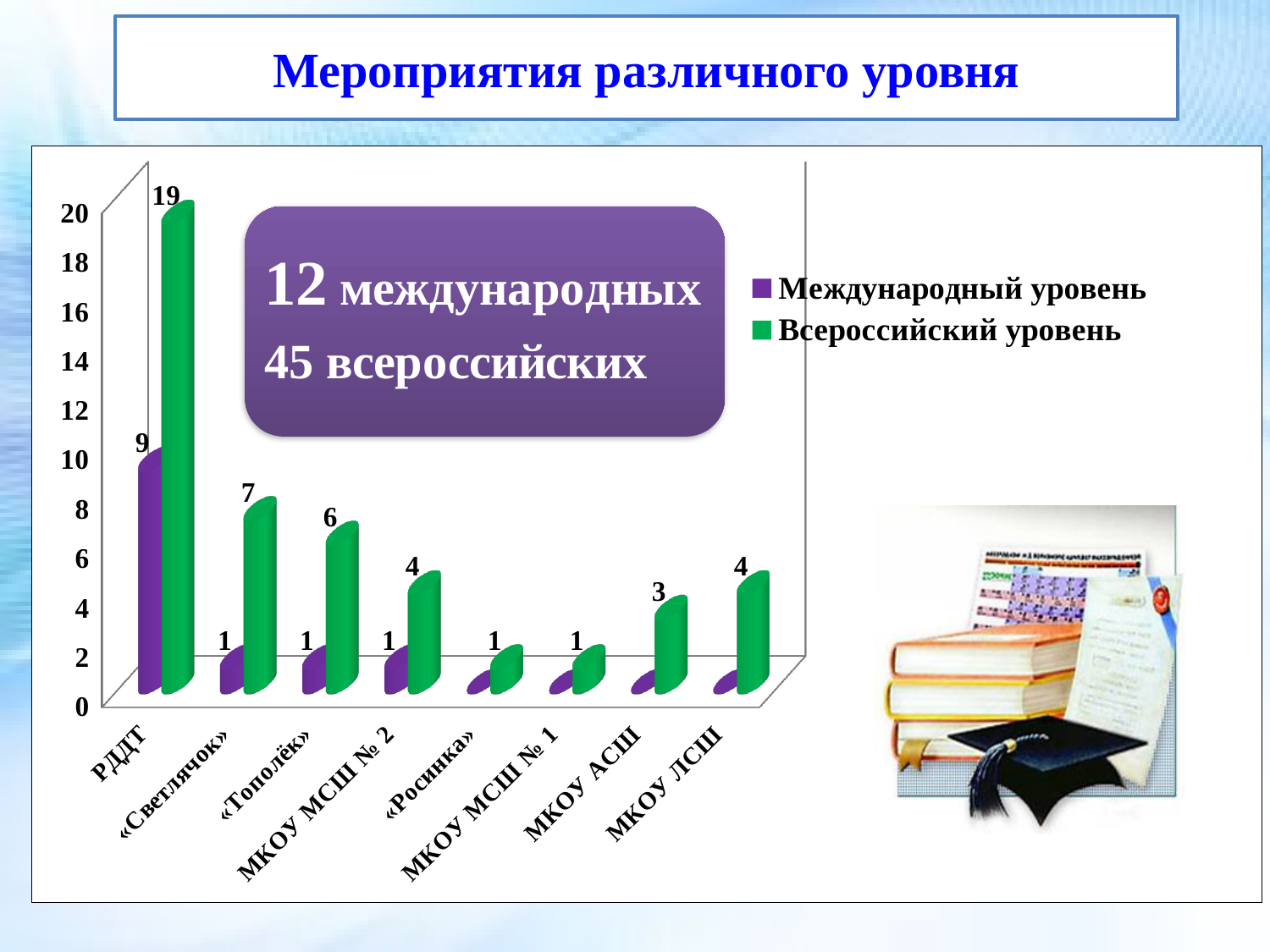
Which category has the highest value in the Всероссийский уровень series? РДДТ What is the difference between the Всероссийский уровень and Международный уровень values for РДДТ? 10 What is the value for МКОУ АСШ in the Всероссийский уровень series? 3 What is the value for РДДТ in the Всероссийский уровень series? 19 What kind of chart is shown on the slide? bar chart Which is larger in the Всероссийский уровень series: «Тополёк» or МКОУ МСШ № 2? «Тополёк» What is the value for «Светлячок» in the Всероссийский уровень series? 7 How many categories are shown on the x axis? 8 What is the value for РДДТ in the Международный уровень series? 9 Which colour represents the Международный уровень series? purple How many series does the legend list? 2 What is the difference between the Всероссийский уровень values for «Светлячок» and МКОУ ЛСШ? 3